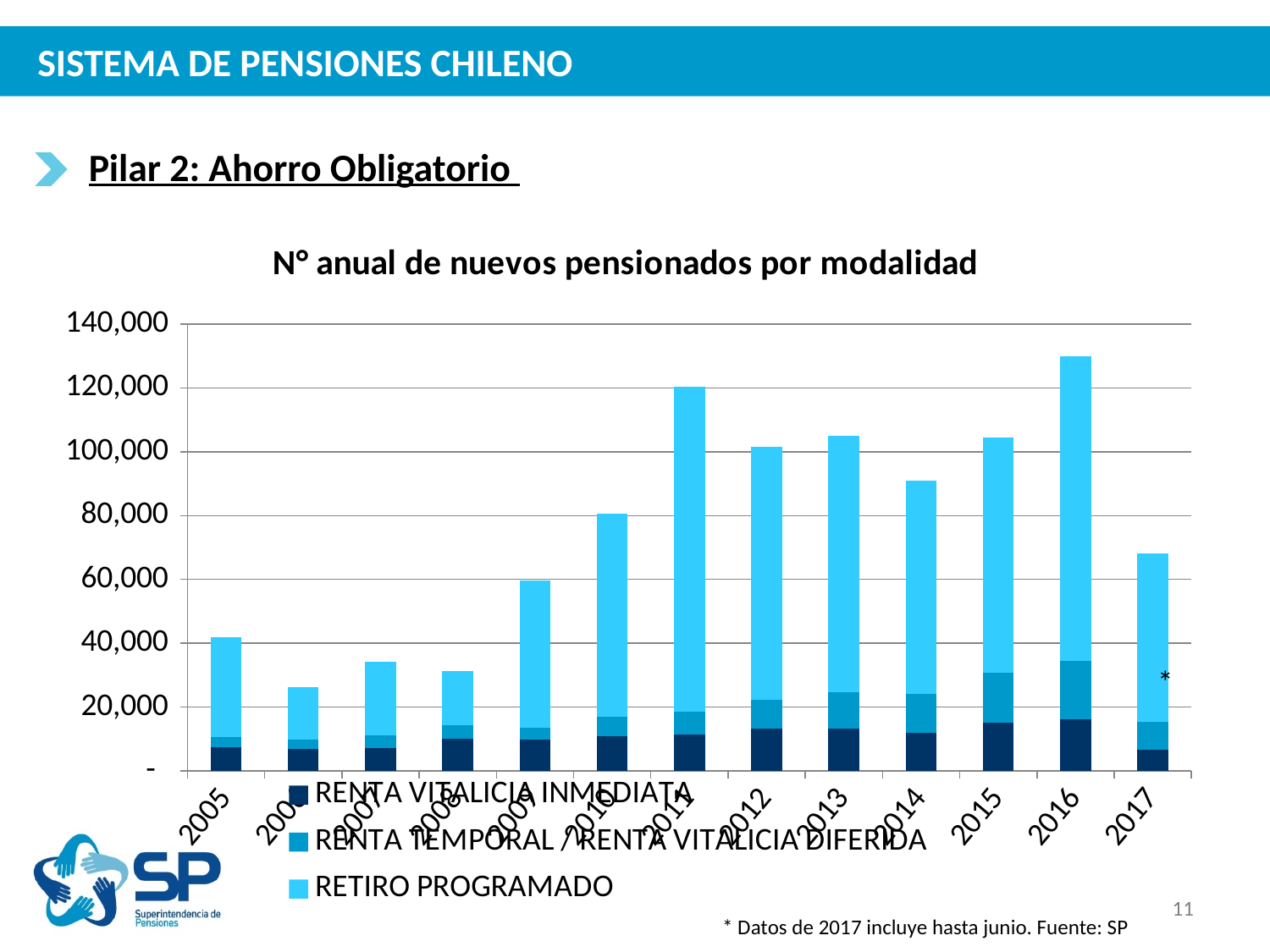
Which legend entry is shown in the lightest blue colour? RETIRO PROGRAMADO How many series does the legend list? 3 What kind of chart is shown on the slide? Stacked bar chart Is the total bar for 2006 greater or less than 40,000? less Is the total bar for 2014 greater or less than 100,000? less What is the title of the chart? N° anual de nuevos pensionados por modalidad Which year has a larger total bar, 2011 or 2012? 2011 How many years are shown on the x axis? 13 Which year has the lowest total bar? 2006 From 2008 to 2011, do the total bars rise or fall? rise Which year has the highest total bar? 2016 Is the total bar for 2011 greater or less than 100,000? greater